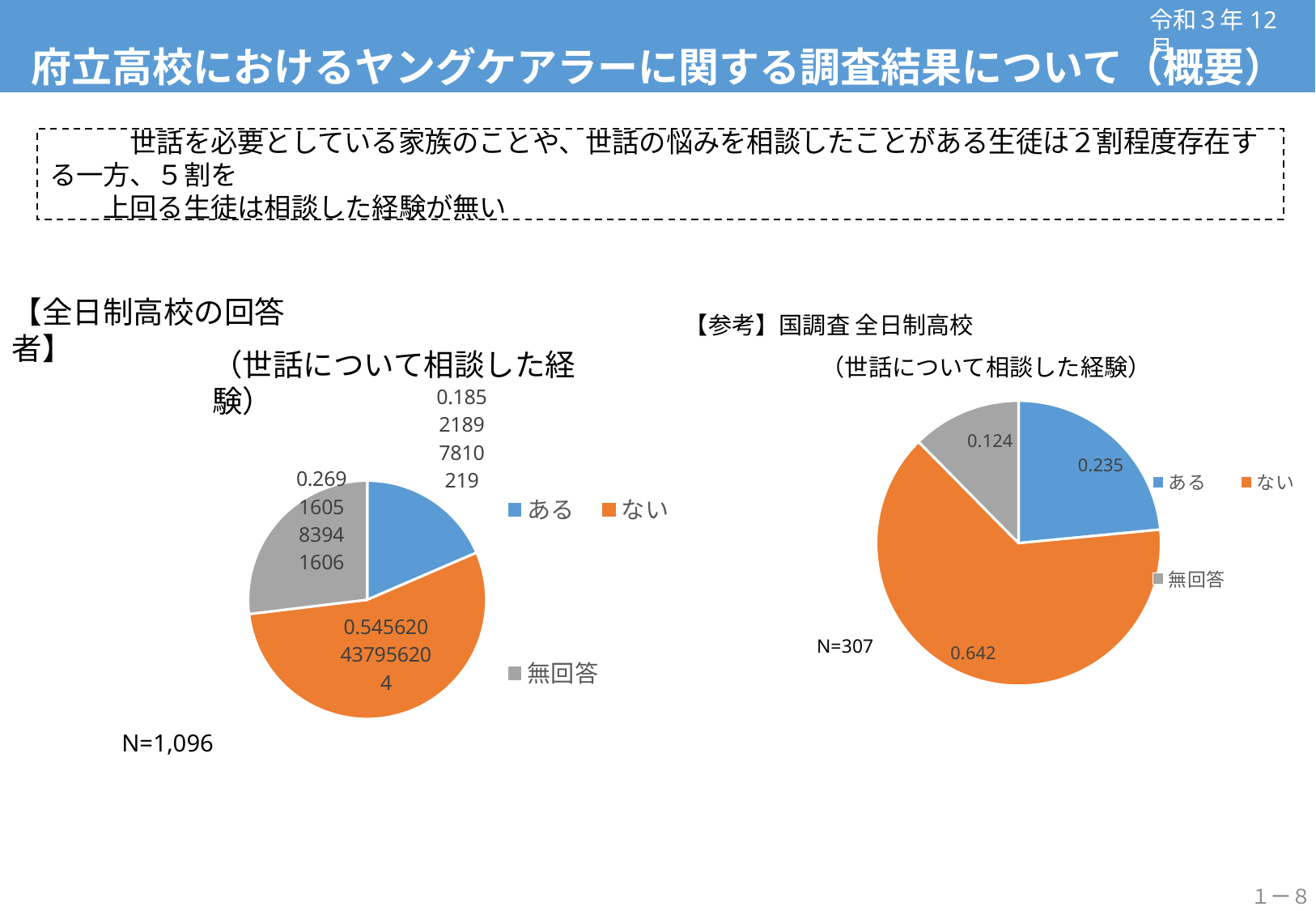
What is the N value shown for the right chart (【参考】国調査 全日制高校)? N=307 In the right chart (【参考】国調査 全日制高校), which category has the smallest share? 無回答 In the left chart (全日制高校の回答者), which is larger, 無回答 or ある? 無回答 In the left chart (全日制高校の回答者), which category has the largest share? ない How many categories does the legend of the left chart (全日制高校の回答者) list? 3 In the left chart (全日制高校の回答者), which category has the smallest share? ある In the right chart (【参考】国調査 全日制高校), what is the value for ない? 0.642 In the right chart (【参考】国調査 全日制高校), what is the difference between the values for ない and ある? 0.407 In the right chart (【参考】国調査 全日制高校), what is the value for 無回答? 0.124 What kind of chart is the left chart (全日制高校の回答者)? pie chart In the right chart (【参考】国調査 全日制高校), what is the value for ある? 0.235 In the right chart (【参考】国調査 全日制高校), which category has the largest share? ない